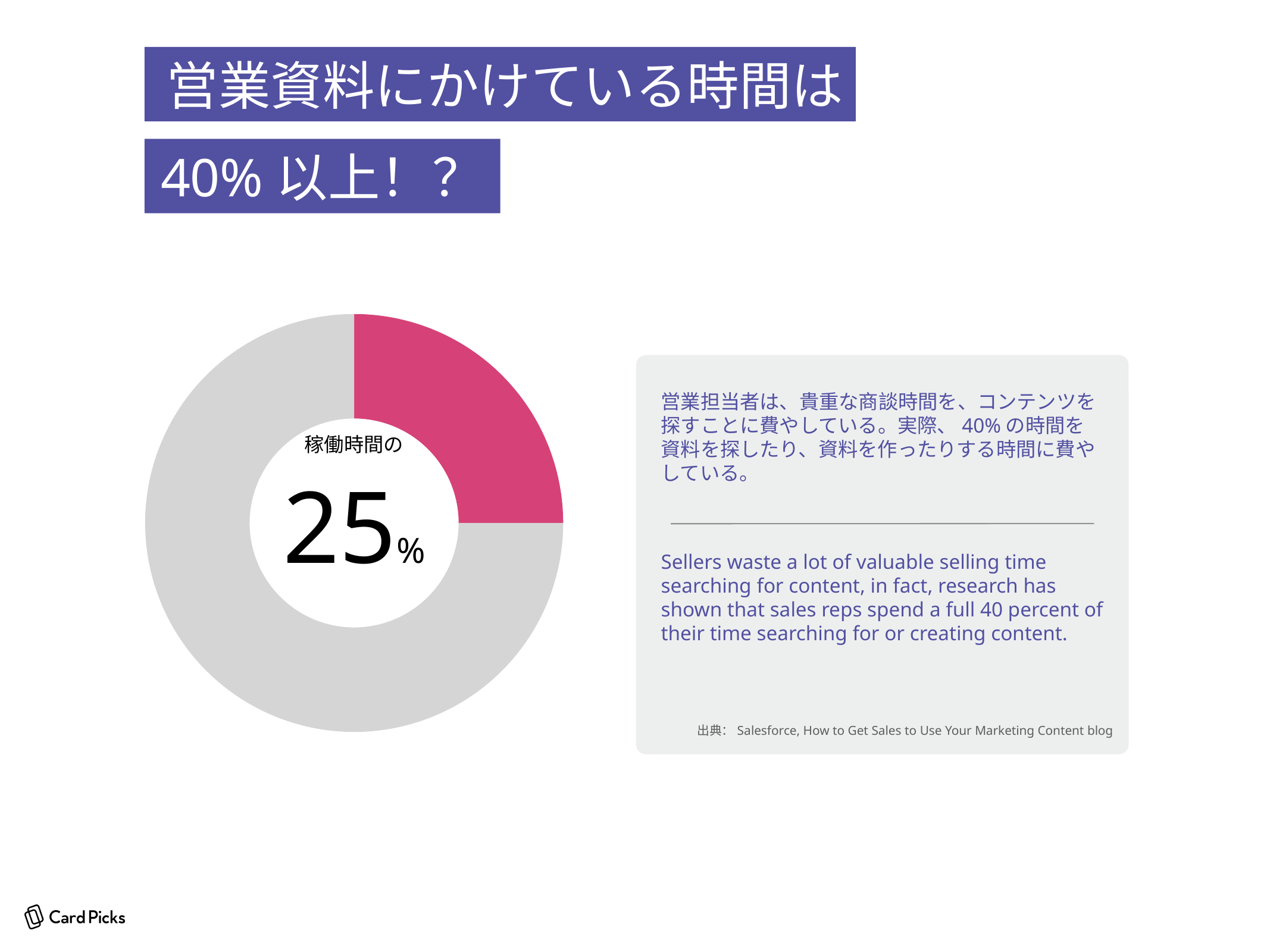
What Japanese label appears above the 25% figure in the centre of the donut chart? 稼働時間の Which slice of the donut chart is larger, the pink one or the grey one? The grey one What percentage is printed in the centre of the donut chart? 25% What colour is the highlighted 25% slice of the donut chart? Pink How many slices does the donut chart have? 2 Which slice of the donut chart is the smallest? The pink slice (25%) What is the difference in share between the grey slice and the pink slice of the donut chart? 50% What kind of chart is shown on the slide? Donut (pie) chart What share of the donut chart does the pink (highlighted) slice represent? 25% What share of the donut chart does the grey slice represent? 75%